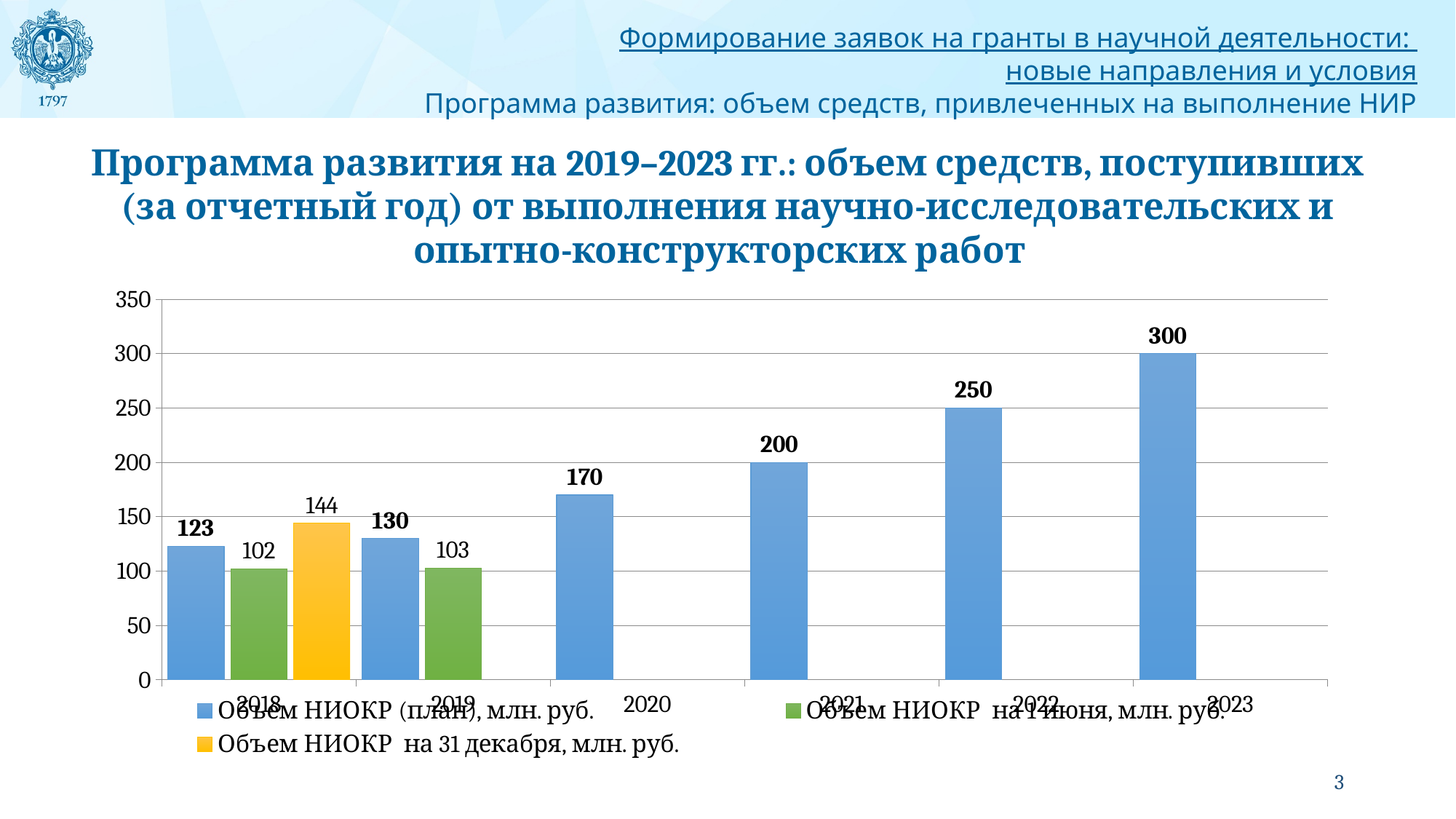
What colour are the bars for 'Объем НИОКР на 1 июня, млн. руб.'? Green In 2018, which is larger: the planned volume or the volume as of 31 December? Volume as of 31 December (144) Do the planned R&D volumes (blue bars) rise or fall from 2018 to 2023? Rise Which year has the highest planned R&D volume (blue bars)? 2023 Which year has the lowest planned R&D volume (blue bars)? 2018 How many series does the legend list? 3 What is the value of the 'Объем НИОКР на 1 июня' bar for 2019? 103 What type of chart is shown on the slide? Bar chart What is the planned R&D volume (Объем НИОКР (план)) for 2023? 300 What is the difference between the planned R&D volume for 2022 and for 2021? 50 What is the value of the 'Объем НИОКР на 31 декабря' bar for 2018? 144 How many years are shown on the x axis? 6